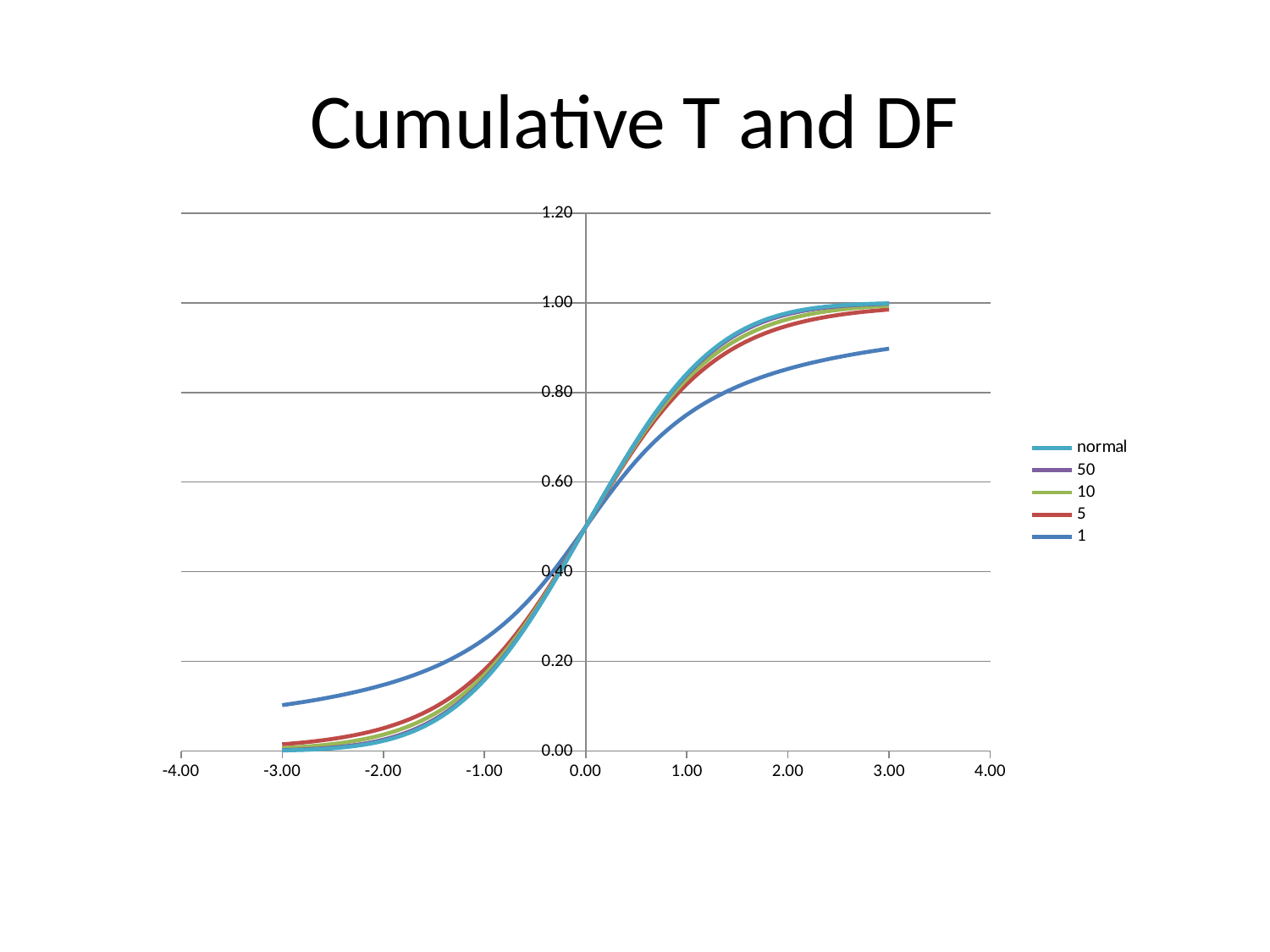
Is the value for series 1 at x = 3.00 greater or less than 1.00? less Which series has the lowest value at x = 3.00? 1 At x = 3.00, which series has the larger value, normal or 1? normal How many series does the legend list? 5 What is the title of the chart? Cumulative T and DF What kind of chart is shown on the slide? line chart Which series are listed in the legend? normal, 50, 10, 5, 1 At x = -3.00, which series has the larger value, 1 or 5? 1 Which series has the highest value at x = -3.00? 1 Is the value for series 1 at x = 3.00 greater or less than 0.80? greater Do the values of the series rise or fall as x increases from -3.00 to 3.00? rise Is the value for the normal series at x = -3.00 greater or less than 0.20? less